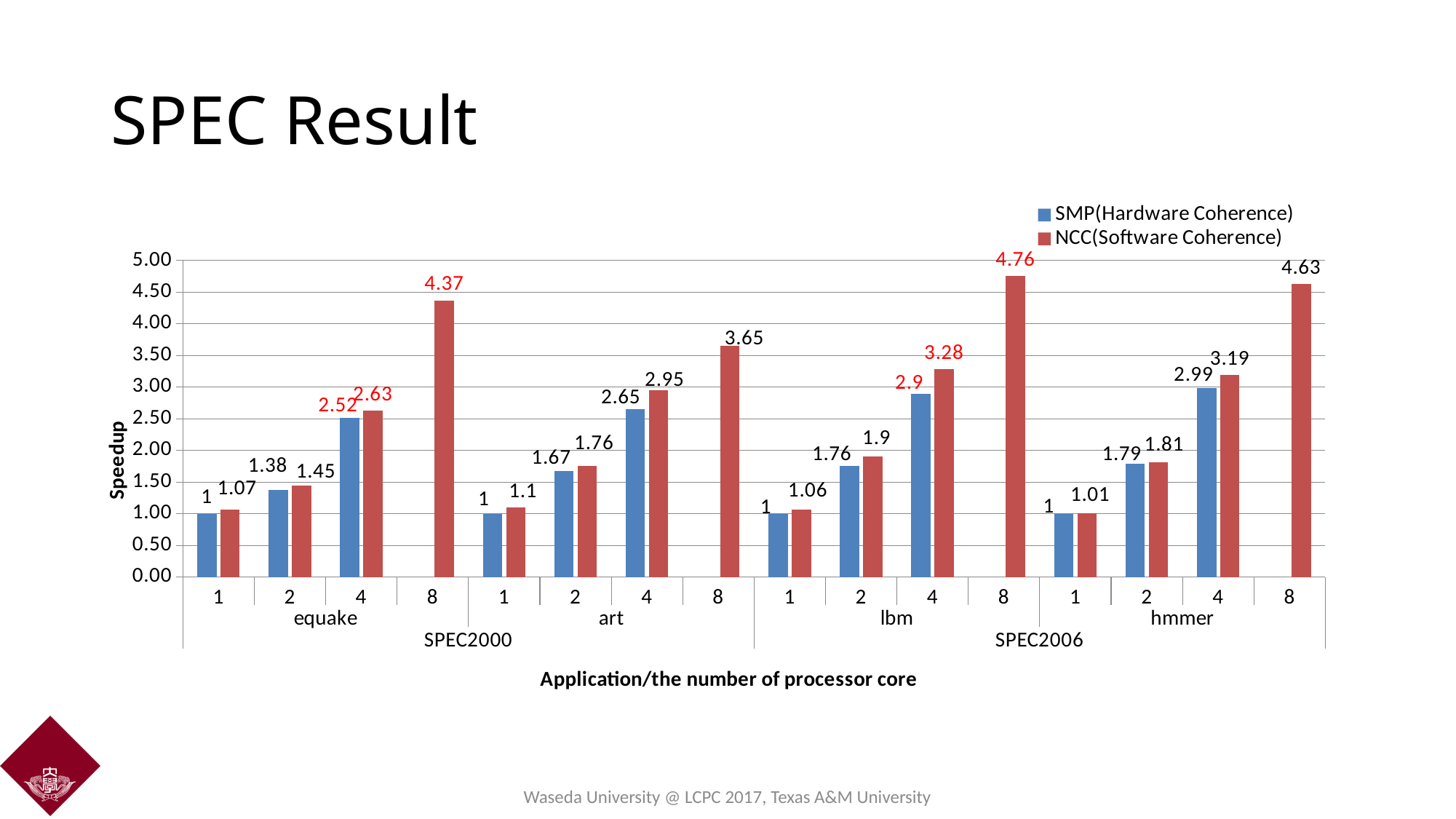
Which is larger for equake with 2 cores: the SMP speedup or the NCC speedup? NCC speedup (1.45) Is the NCC(Software Coherence) speedup for hmmer with 8 cores greater or less than 4.50? greater How does the NCC(Software Coherence) speedup for art change as the number of processor cores increases from 1 to 8? It rises What is the NCC(Software Coherence) speedup for equake with 8 processor cores? 4.37 What is the SMP(Hardware Coherence) speedup for art with 4 processor cores? 2.65 How many series does the legend list? 2 What is the label of the vertical axis? Speedup What is the difference between the NCC speedup for lbm with 8 cores and the NCC speedup for art with 8 cores? 1.11 What is the NCC(Software Coherence) speedup for lbm with 2 processor cores? 1.9 Which application and core count has the highest NCC(Software Coherence) speedup? lbm with 8 cores (4.76) What is the difference between the NCC and SMP speedups for hmmer with 4 processor cores? 0.2 What kind of chart is shown on the slide? Bar chart